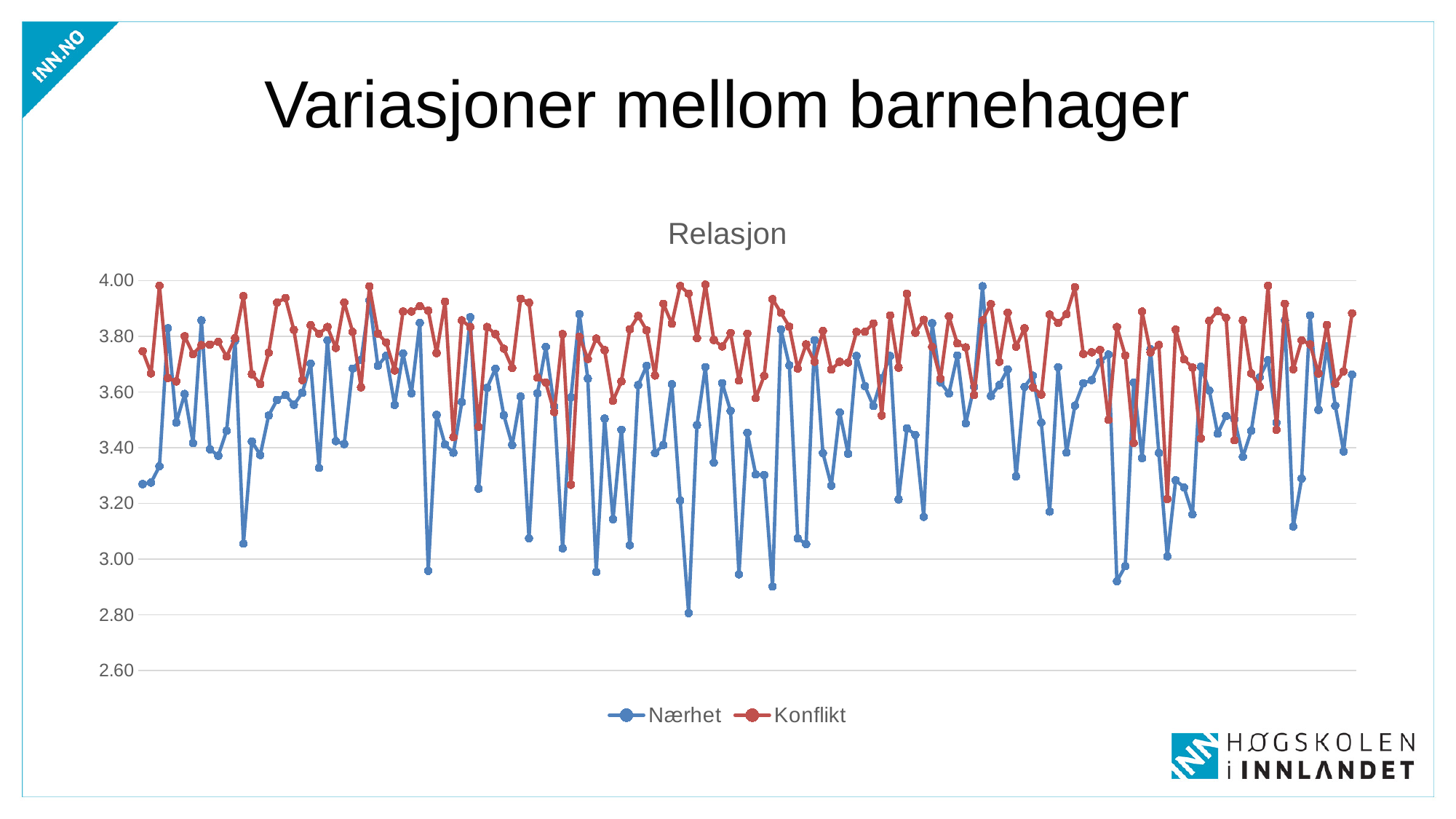
Which series generally has the higher values across the chart, Nærhet or Konflikt? Konflikt Which series is drawn in red? Konflikt What kind of chart is shown on the slide? line chart What is the lowest value shown on the y axis? 2.60 Is the lowest point of the Konflikt series greater or less than 3.40? less What is the title of the chart? Relasjon Is the highest point of the Konflikt series greater or less than 3.80? greater Does the Nærhet series ever drop below 3.00 on the y axis? yes How many series does the legend list? 2